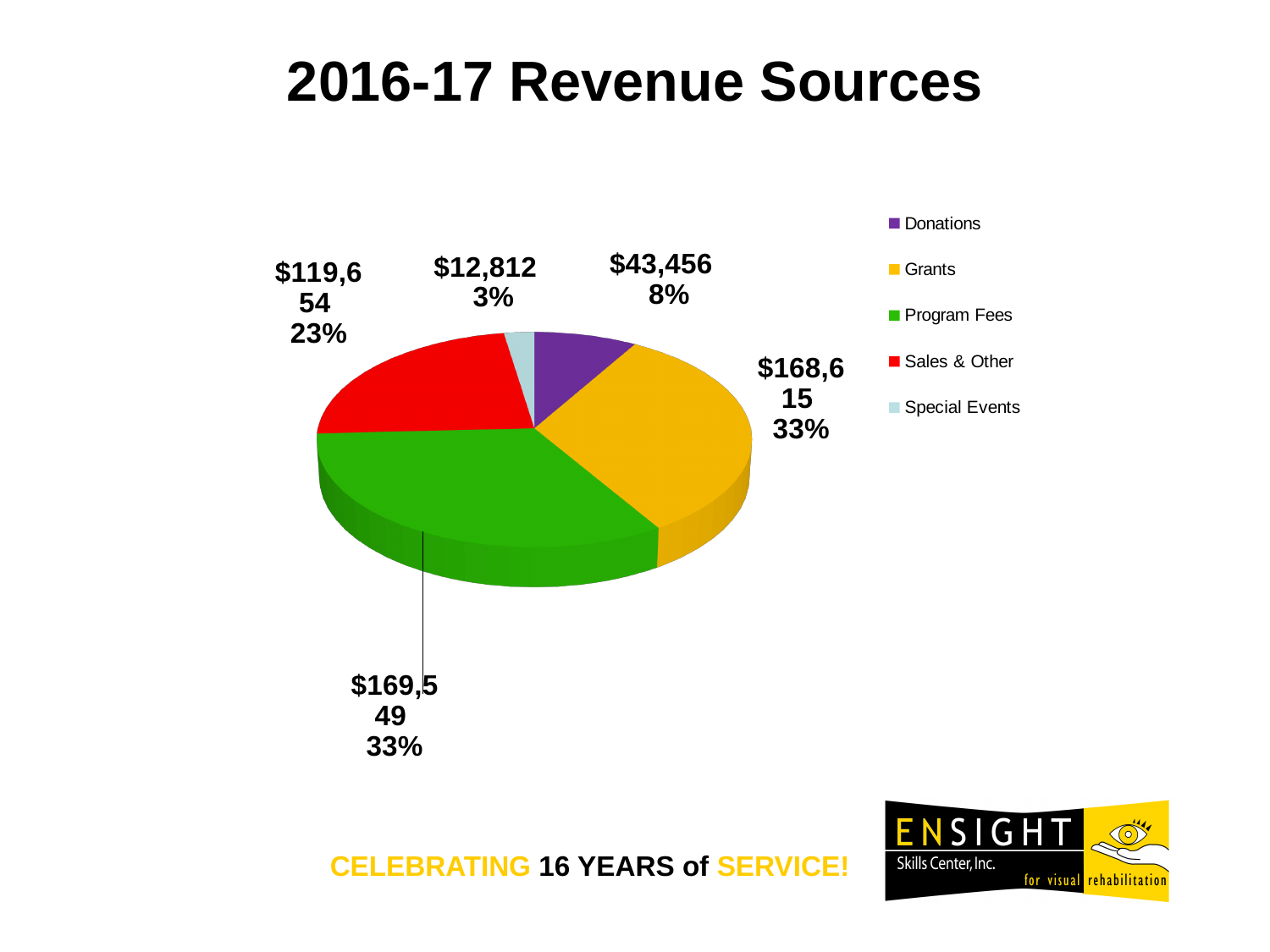
What is the revenue value for Donations? $43,456 What share of revenue comes from Grants? 33% Which is larger, Sales & Other or Donations? Sales & Other What is the title of the chart? 2016-17 Revenue Sources Which revenue source has the largest dollar value? Program Fees What is the difference in dollars between Donations and Special Events? $30,644 What kind of chart is shown on the slide? pie chart What share of revenue comes from Sales & Other? 23% How many revenue sources are shown in the pie chart? 5 What is the revenue value for Special Events? $12,812 What is the revenue value for Sales & Other? $119,654 Which revenue source has the smallest slice? Special Events